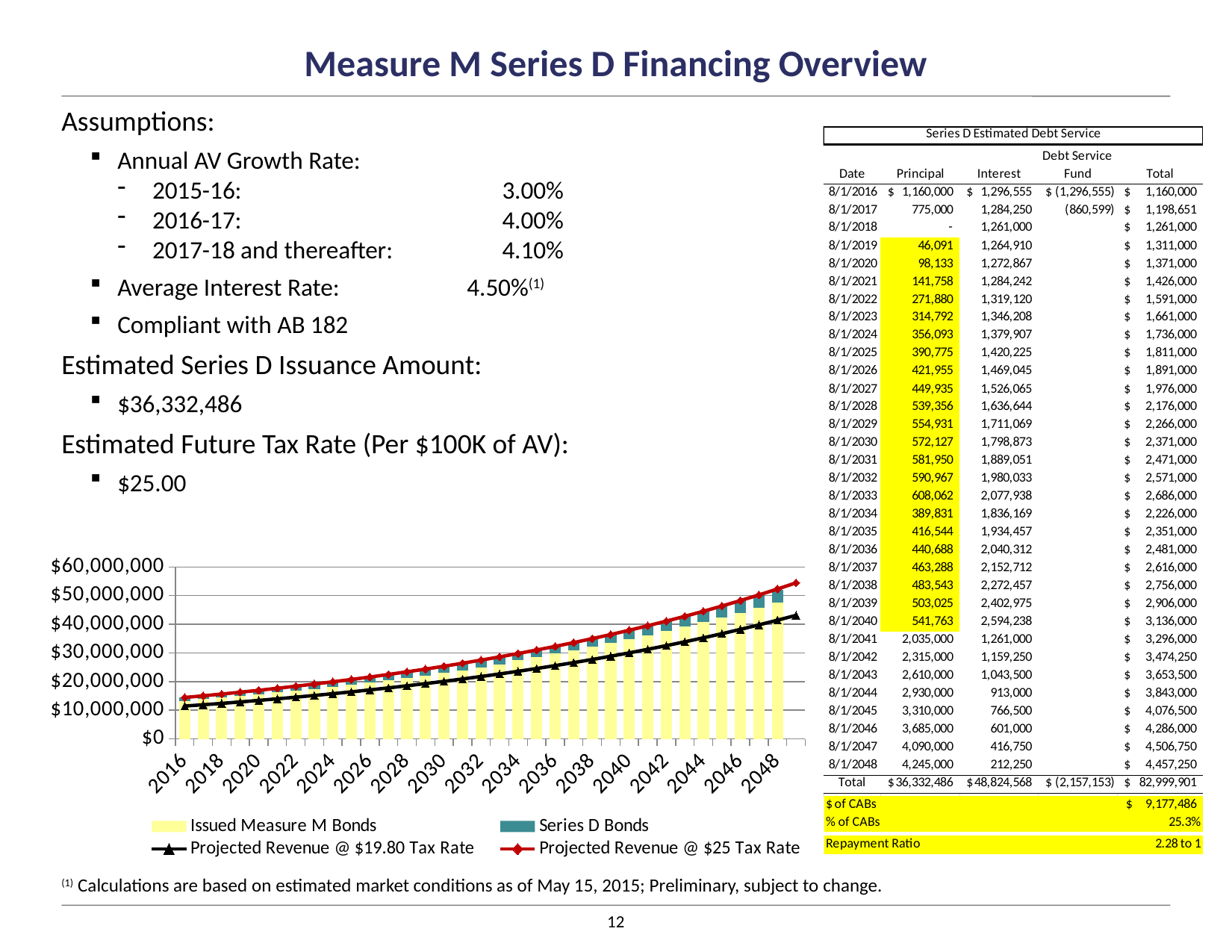
Does the Projected Revenue @ $25 Tax Rate line rise or fall from 2016 to 2048? Rise How many series does the chart legend list? 4 In 2048, which is larger: Projected Revenue @ $25 Tax Rate or Projected Revenue @ $19.80 Tax Rate? Projected Revenue @ $25 Tax Rate What is the highest value shown on the chart's vertical axis? $60,000,000 What kind of chart is shown on the slide? A combined stacked bar and line chart Which series are shown as bars in the chart? Issued Measure M Bonds and Series D Bonds How many year labels are shown on the chart's x axis? 17 In which year is the Projected Revenue @ $19.80 Tax Rate lowest? 2016 Is the Projected Revenue @ $25 Tax Rate in 2048 greater or less than $50,000,000? greater Is the Projected Revenue @ $25 Tax Rate in 2040 greater or less than $30,000,000? greater